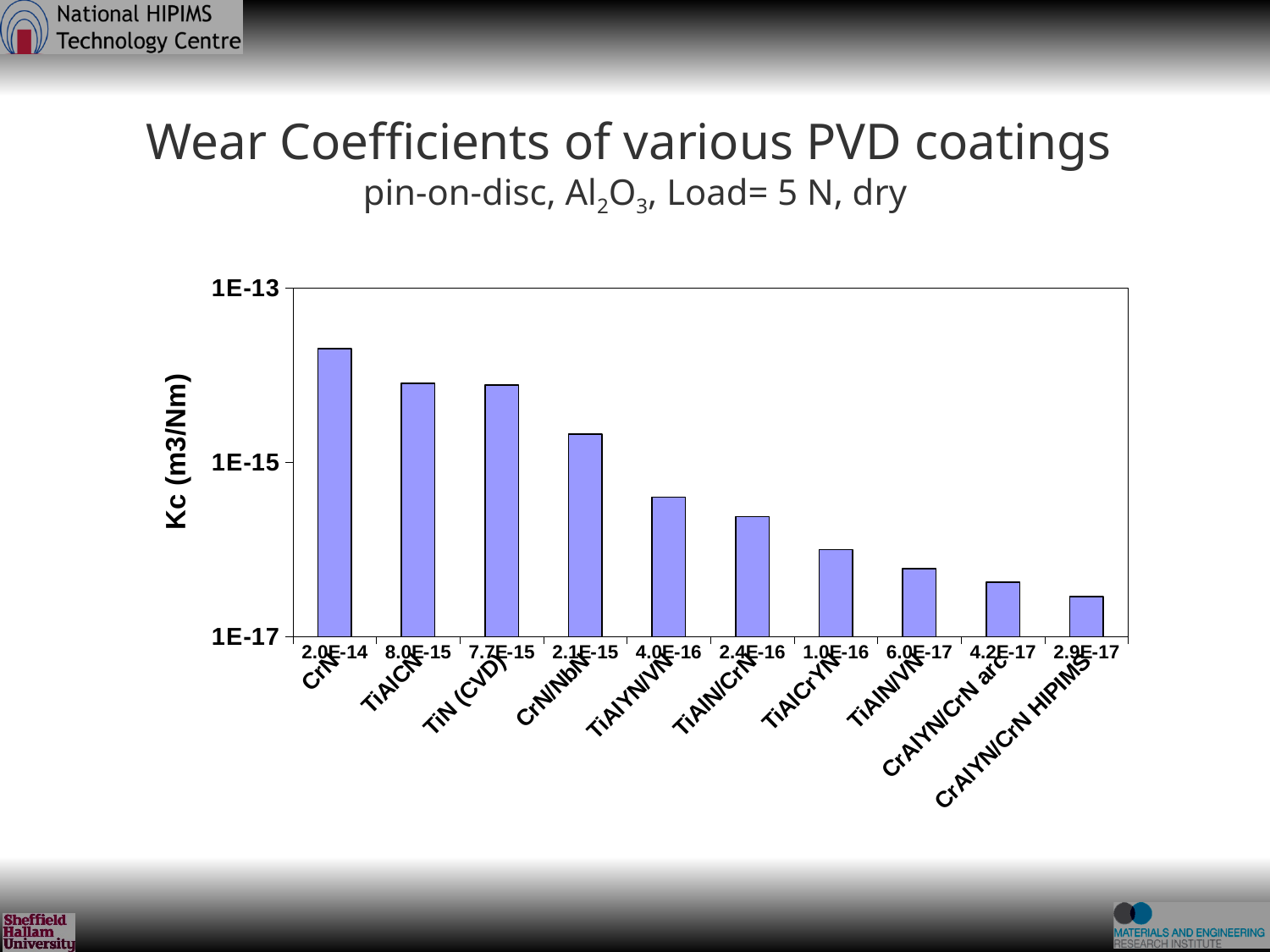
Which has the larger wear coefficient, CrN/NbN or TiAlN/CrN? CrN/NbN Do the wear coefficient values rise or fall from left to right along the x axis? fall Which coating has the lowest wear coefficient? CrAlYN/CrN HIPIMS Which coating has the highest wear coefficient? CrN How many coatings (bars) are plotted in the chart? 10 What is the label on the y axis of the chart? Kc (m3/Nm) What is the wear coefficient Kc for CrAlYN/CrN HIPIMS? 2.9E-17 What kind of chart is shown on the slide? bar chart Is the wear coefficient for TiAlCN greater or less than 1E-15? greater What is the wear coefficient Kc for CrN? 2.0E-14 What is the wear coefficient Kc for TiAlYN/VN? 4.0E-16 What is the wear coefficient Kc for CrAlYN/CrN arc? 4.2E-17